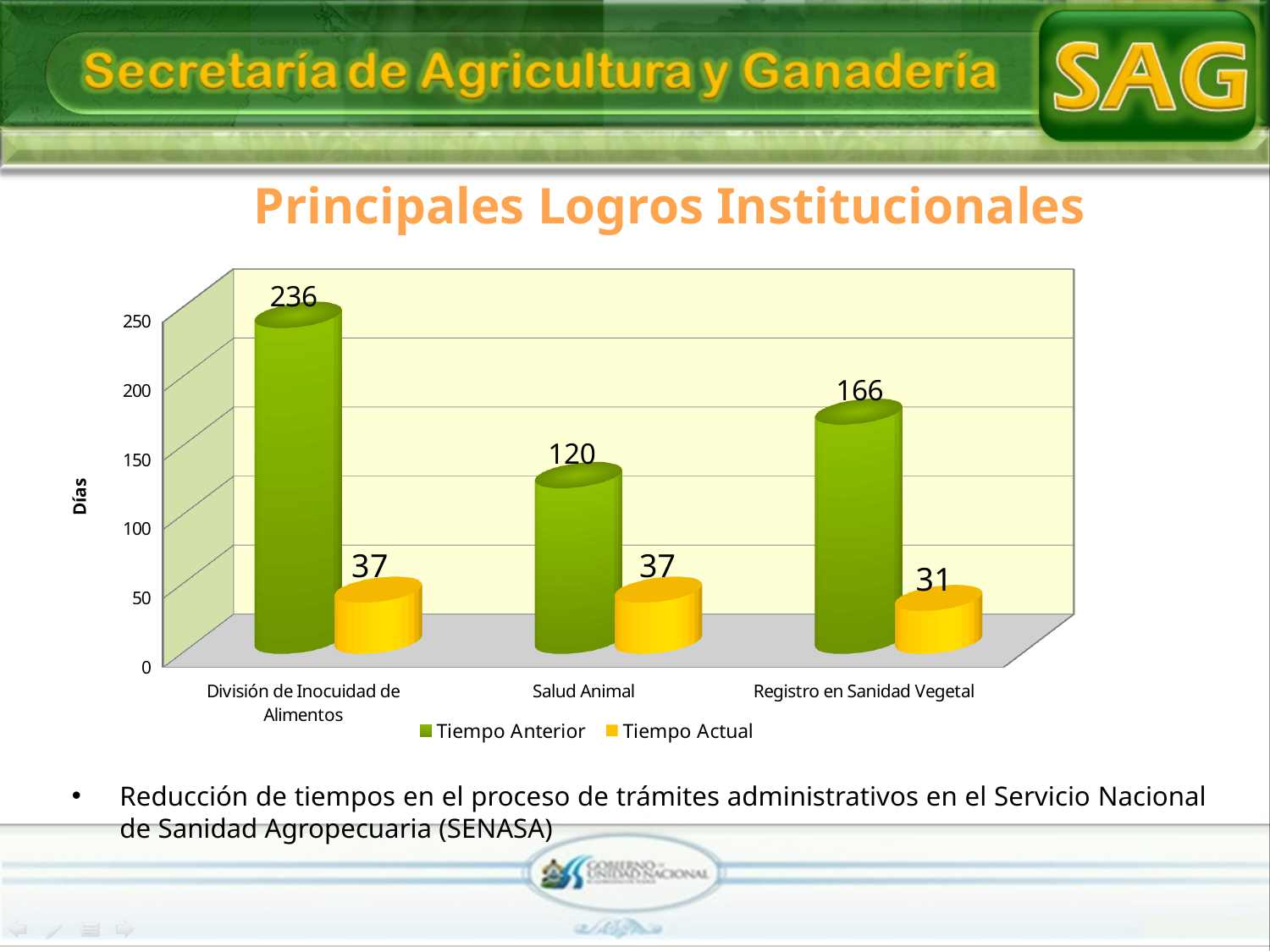
What is the Tiempo Anterior value for División de Inocuidad de Alimentos? 236 What is the difference between Tiempo Anterior and Tiempo Actual for Registro en Sanidad Vegetal? 135 What is the label of the vertical axis? Días How many series does the legend list? 2 What is the Tiempo Actual value for Registro en Sanidad Vegetal? 31 What kind of chart is shown on the slide? Bar chart What is the difference between the Tiempo Anterior values for División de Inocuidad de Alimentos and Salud Animal? 116 Which is larger: the Tiempo Anterior value for Salud Animal or for Registro en Sanidad Vegetal? Registro en Sanidad Vegetal Which category has the lowest Tiempo Actual value? Registro en Sanidad Vegetal Which category has the highest Tiempo Anterior value? División de Inocuidad de Alimentos What is the Tiempo Anterior value for Salud Animal? 120 How many categories are shown on the x axis? 3